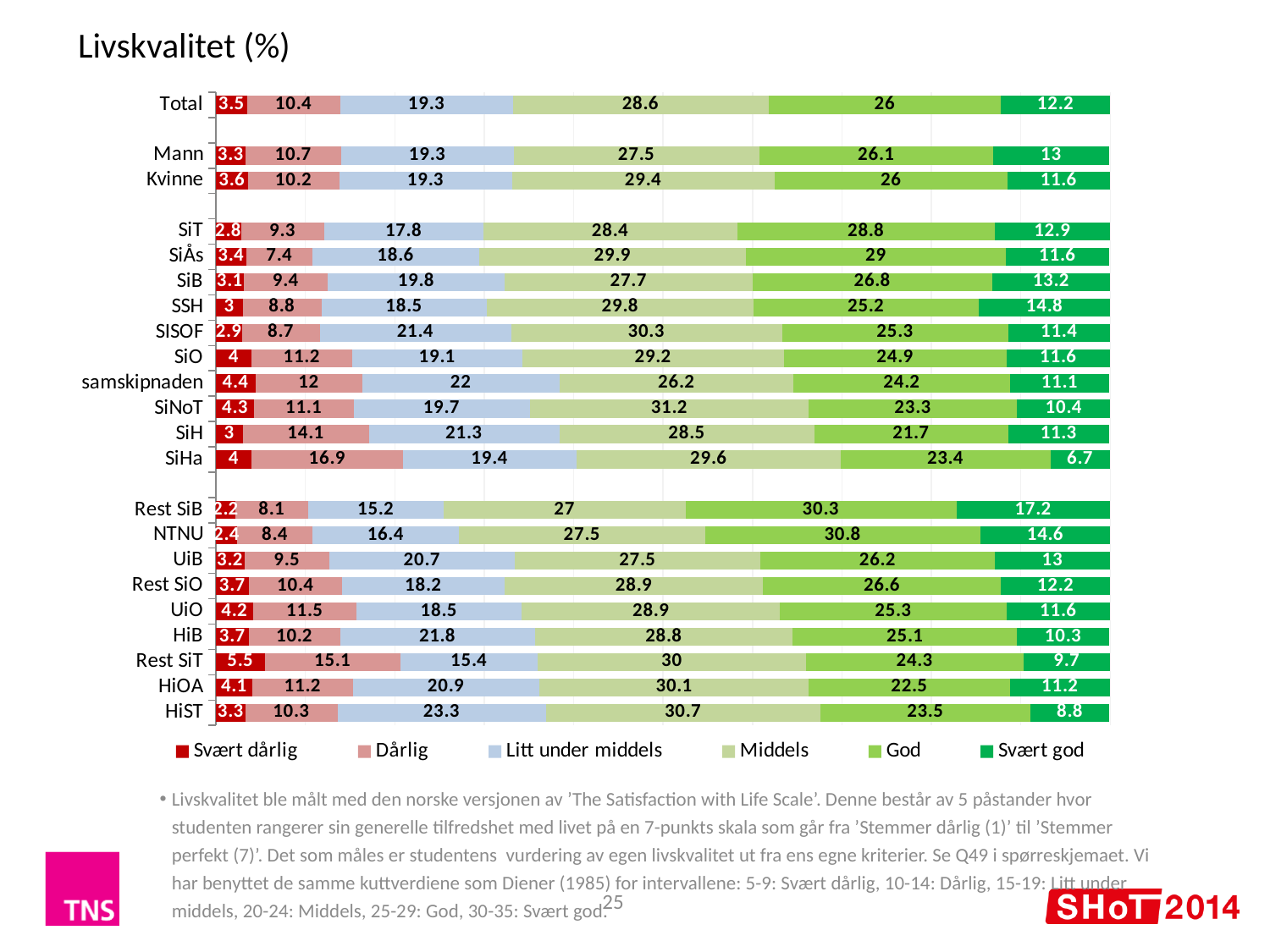
Which category has the highest Svært god value? Rest SiB Which category has the lowest Svært god value? SiHa What kind of chart is this? Stacked bar chart What is the Svært god value for SiHa? 6.7 What is the Svært dårlig value for Rest SiT? 5.5 What is the total of the stacked bar for Total? 100 How many series does the legend list? 6 Which has a larger God value, NTNU or UiO? NTNU What is the difference between the Svært god values for Mann and Kvinne? 1.4 How many categories are shown on the y axis? 22 What is the value of the Middels segment for Total? 28.6 Which category has the highest Dårlig value? SiHa